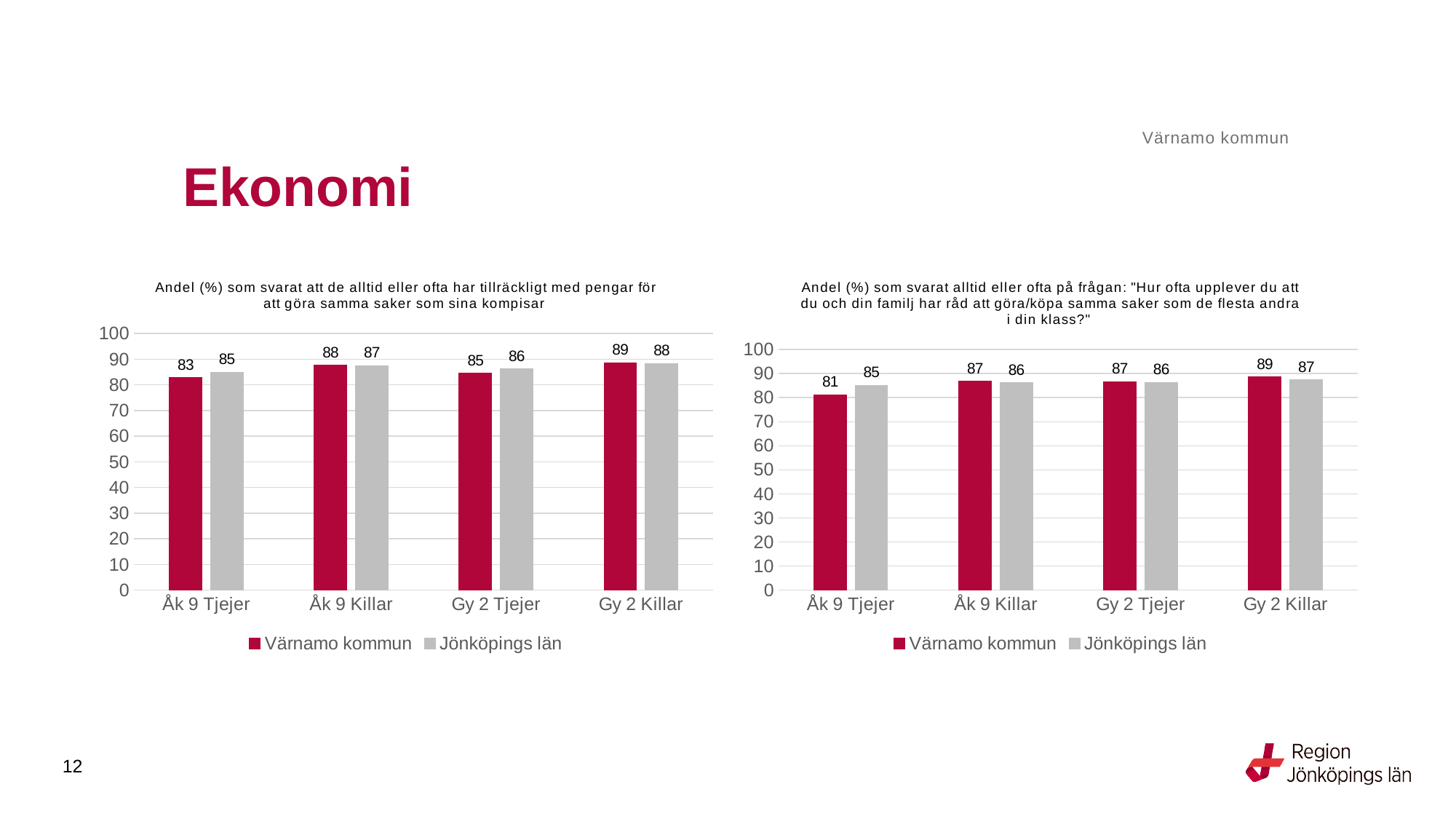
How many categories are shown on the x axis of the left chart? 4 How many series does the legend of the right chart list? 2 In the left chart, which is larger for Åk 9 Tjejer: Värnamo kommun or Jönköpings län? Jönköpings län In the left chart, what is the value for Jönköpings län for Gy 2 Killar? 88 In the right chart, what colour are the Värnamo kommun bars? Red In the right chart, what is the difference between Jönköpings län and Värnamo kommun for Åk 9 Tjejer? 4 In the right chart, what is the value for Värnamo kommun for Åk 9 Tjejer? 81 In the left chart, what is the value for Värnamo kommun for Åk 9 Tjejer? 83 What kind of chart is the left chart? Bar chart In the left chart, which category has the highest value for Värnamo kommun? Gy 2 Killar In the right chart, which category has the lowest value for Värnamo kommun? Åk 9 Tjejer In the right chart, what is the value for Jönköpings län for Gy 2 Killar? 87